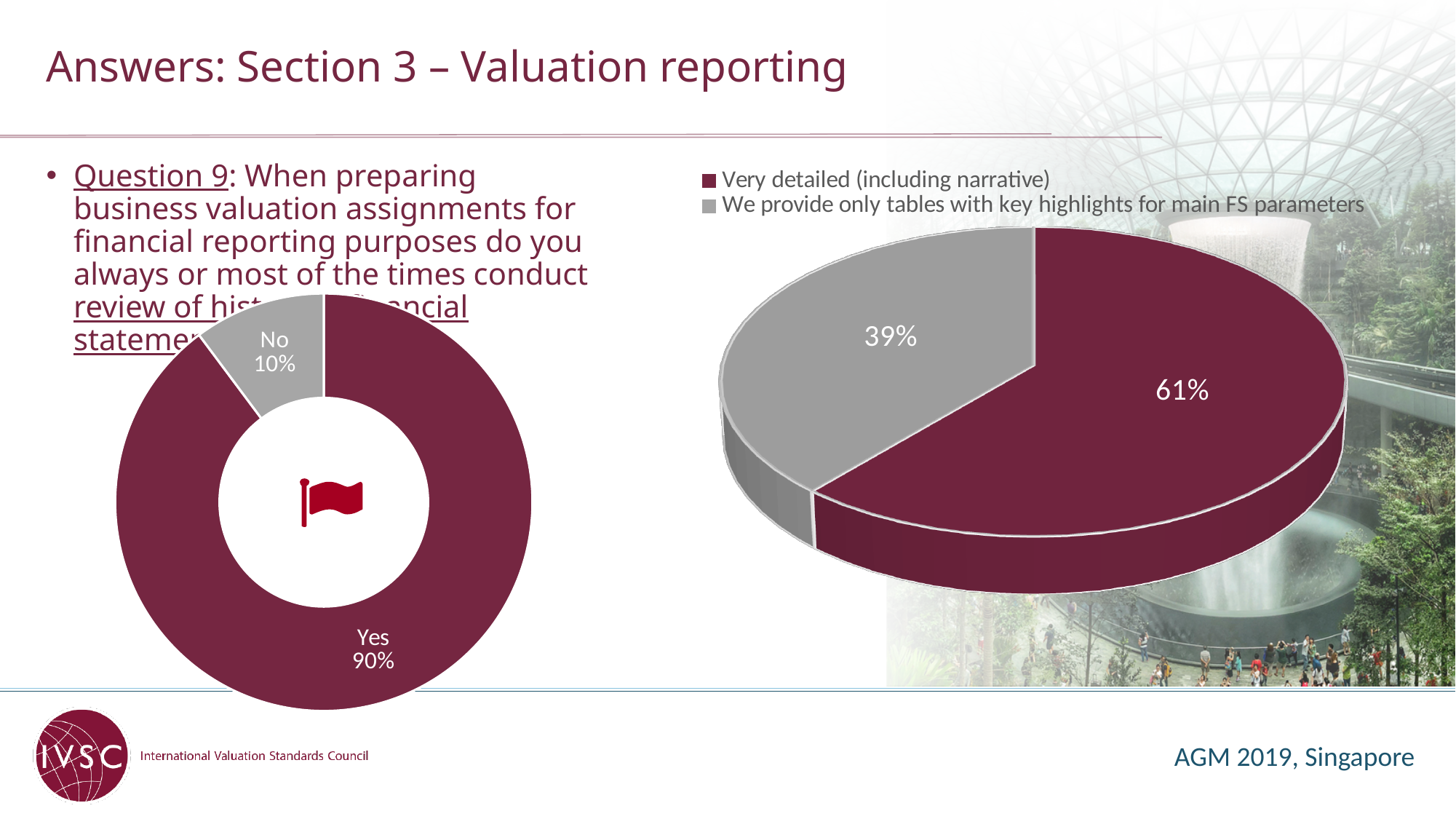
On the pie chart on the right of the slide, how many entries does the legend list? 2 On the donut chart on the left of the slide, how many categories are shown? 2 On the donut chart on the left of the slide, what share of respondents answered Yes? 90% On the pie chart on the right of the slide, what colour is the 'Very detailed (including narrative)' slice? Dark red (maroon) On the donut chart on the left of the slide, what share of respondents answered No? 10% On the donut chart on the left of the slide, what is the difference in percentage points between Yes and No? 80 What kind of chart is shown on the left of the slide? Donut (pie) chart On the donut chart on the left of the slide, which answer has the largest share? Yes On the pie chart on the right of the slide, what is the difference in percentage points between the two slices? 22 On the pie chart on the right of the slide, which category has the smallest share? We provide only tables with key highlights for main FS parameters On the pie chart on the right of the slide, what share corresponds to 'Very detailed (including narrative)'? 61% On the pie chart on the right of the slide, what share corresponds to 'We provide only tables with key highlights for main FS parameters'? 39%